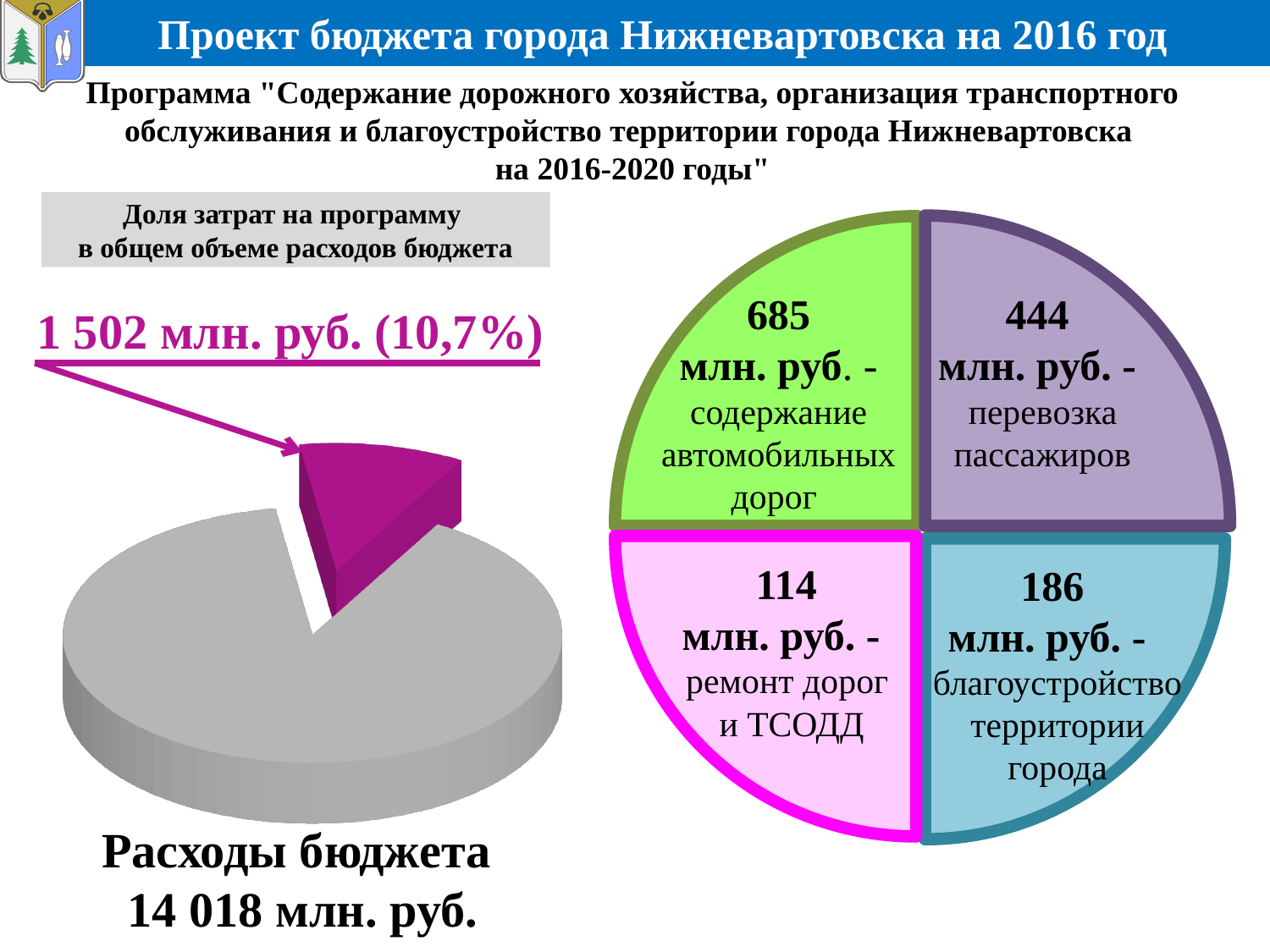
On the right pie chart, which category has the highest value? содержание автомобильных дорог On the left pie chart, what share of total budget expenses does the program account for? 10,7% On the right pie chart, what is the difference between содержание автомобильных дорог and перевозка пассажиров? 241 млн. руб. How many categories does the right pie chart show? 4 On the right pie chart, which is larger: благоустройство территории города or ремонт дорог и ТСОДД? благоустройство территории города On the right pie chart, what is the value for ремонт дорог и ТСОДД? 114 млн. руб. On the right pie chart, which category has the lowest value? ремонт дорог и ТСОДД On the right pie chart, what is the value for содержание автомобильных дорог? 685 млн. руб. On the right pie chart, what is the value for перевозка пассажиров? 444 млн. руб. On the left pie chart, what is the total budget expenses value (Расходы бюджета)? 14 018 млн. руб. What kind of chart is the chart on the left of the slide? pie chart On the right pie chart, what is the value for благоустройство территории города? 186 млн. руб.